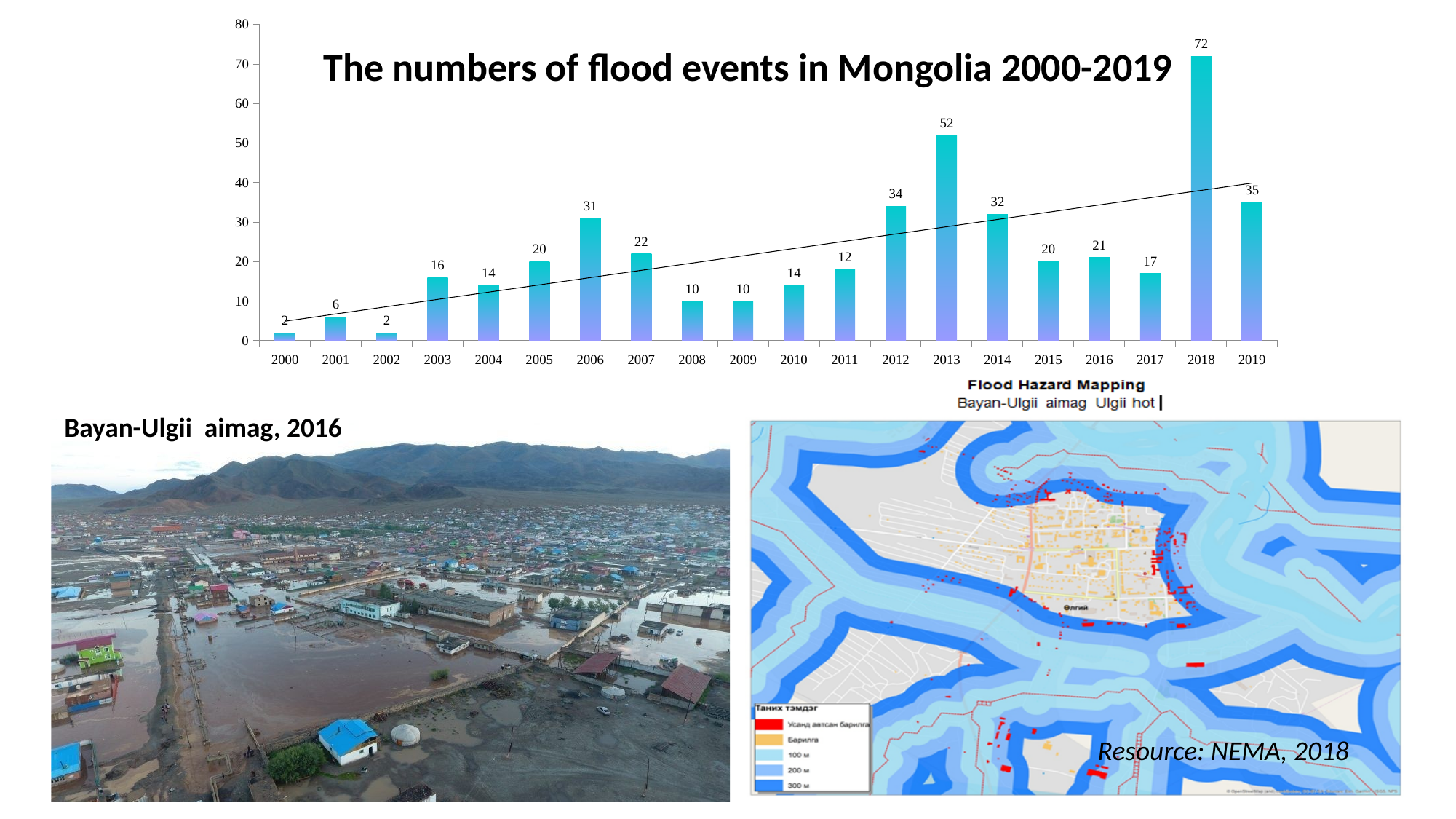
Is the number of flood events in 2019 greater or less than 30? greater Which year had more flood events, 2012 or 2014? 2012 Which year has the highest number of flood events? 2018 What kind of chart is used to show the flood events? bar chart What is the title of the chart? The numbers of flood events in Mongolia 2000-2019 What is the number of flood events in 2013? 52 According to the trend line, do flood events generally rise or fall from 2000 to 2019? rise How many years are shown on the x axis of the chart? 20 What is the difference in flood events between 2018 and 2013? 20 What is the number of flood events in 2018? 72 What is the number of flood events in 2006? 31 What is the difference in flood events between 2016 and 2017? 4